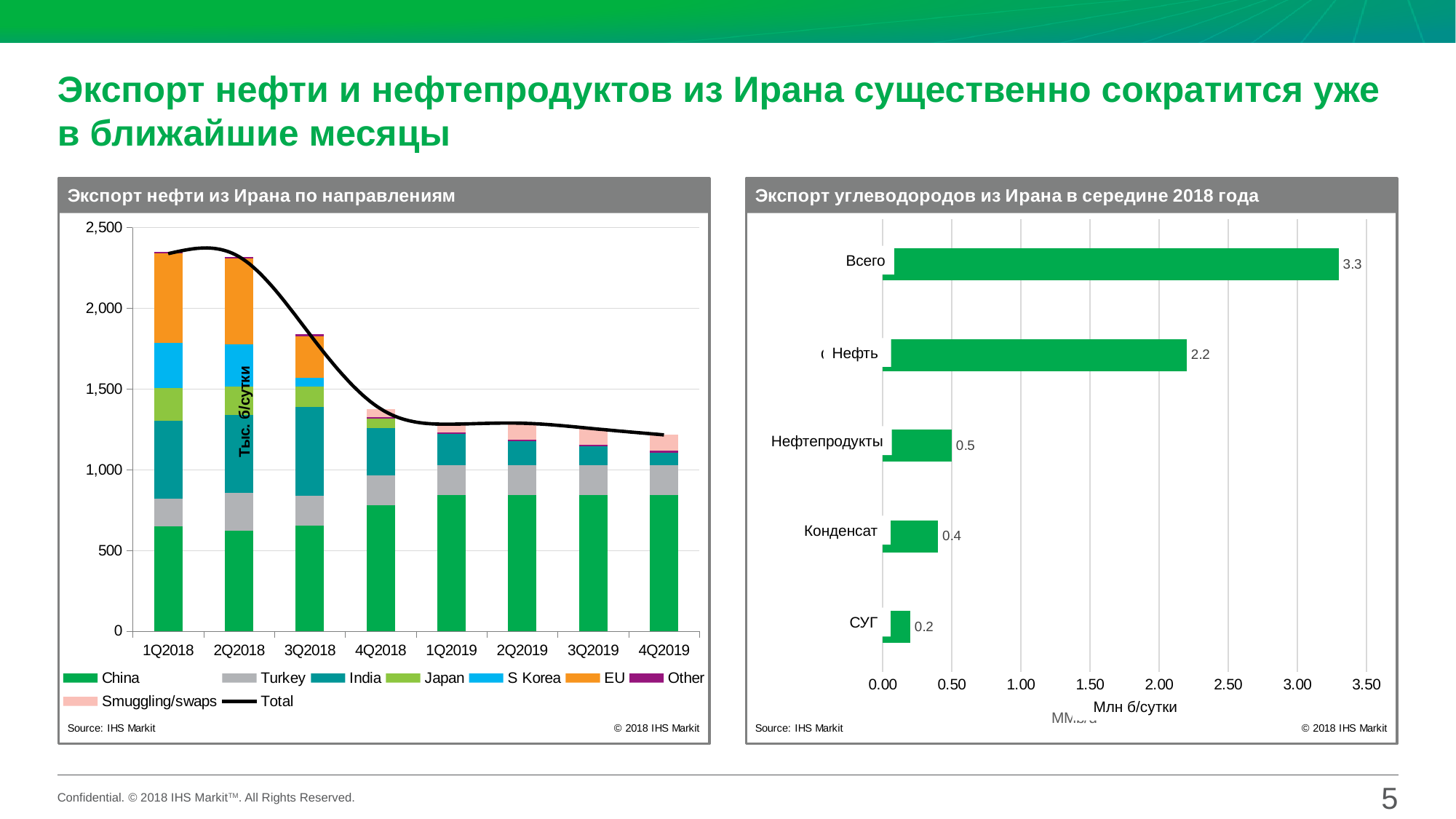
In the chart 'Экспорт нефти из Ирана по направлениям', what kind of chart is used? Stacked bar chart with a line In the chart 'Экспорт нефти из Ирана по направлениям', how many quarters are shown on the x axis? 8 In the chart 'Экспорт углеводородов из Ирана в середине 2018 года', what is the difference between the values for Нефть and Нефтепродукты? 1.7 In the chart 'Экспорт углеводородов из Ирана в середине 2018 года', which category has the lowest value? СУГ In the chart 'Экспорт нефти из Ирана по направлениям', is the Total value for 4Q2019 greater or less than 1,500? less In the chart 'Экспорт нефти из Ирана по направлениям', does the Total line rise or fall from 1Q2018 to 4Q2019? Fall In the chart 'Экспорт углеводородов из Ирана в середине 2018 года', what is the value for Нефтепродукты? 0.5 In the chart 'Экспорт углеводородов из Ирана в середине 2018 года', what is the value for Всего? 3.3 In the chart 'Экспорт углеводородов из Ирана в середине 2018 года', how many categories are shown? 5 In the chart 'Экспорт нефти из Ирана по направлениям', is the Total value for 1Q2018 greater or less than 2,000? greater In the chart 'Экспорт углеводородов из Ирана в середине 2018 года', which is larger: Конденсат or СУГ? Конденсат In the chart 'Экспорт нефти из Ирана по направлениям', how many entries does the legend list? 9